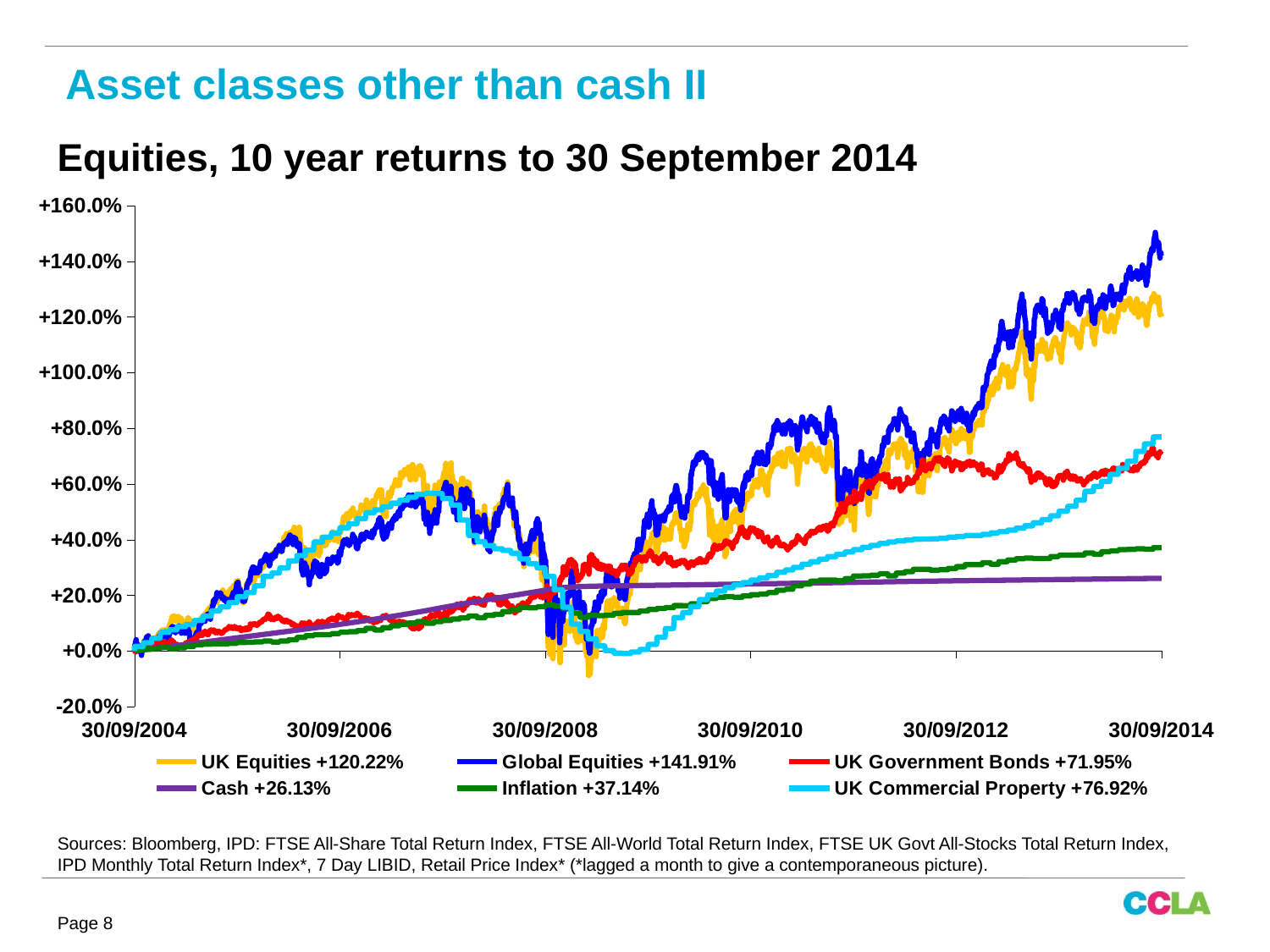
What kind of chart is shown on the slide? line chart What 10 year return does the legend give for Cash? +26.13% Which has the larger 10 year return in the legend, UK Commercial Property or UK Government Bonds? UK Commercial Property What is the difference between the 10 year returns of Global Equities and UK Equities shown in the legend? 21.69% Does the Cash line rise or fall from 30/09/2004 to 30/09/2014? rise Which series has the highest 10 year return shown in the legend? Global Equities What 10 year return does the legend give for Global Equities? +141.91% How many series does the legend list? 6 What 10 year return does the legend give for UK Commercial Property? +76.92% What colour is the Inflation line? green Which series has the lowest 10 year return shown in the legend? Cash